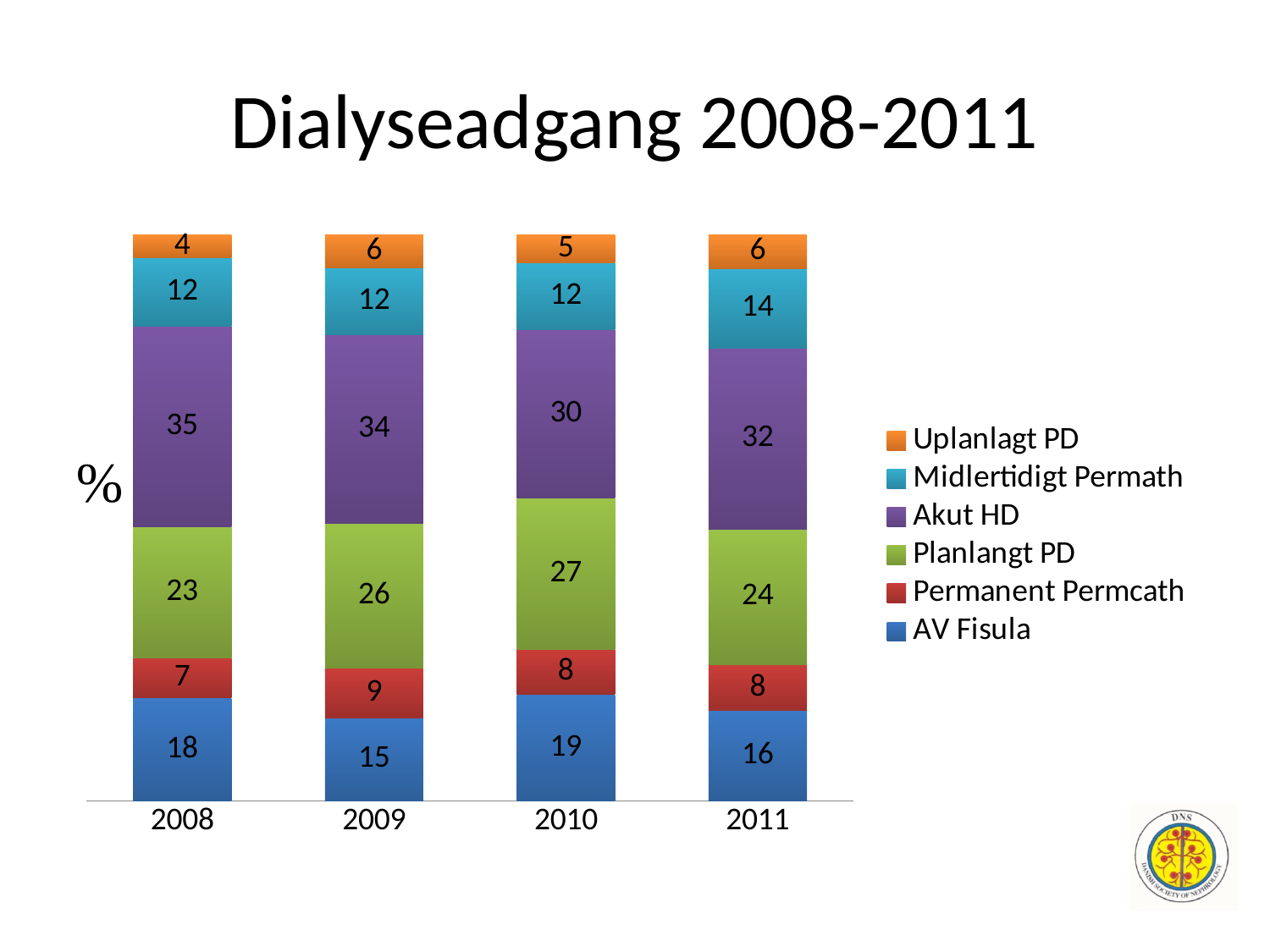
How many series does the legend list? 6 What is the value for Akut HD in 2008? 35 How many years are shown on the x axis? 4 In which year is the AV Fisula value lowest? 2009 What type of chart is shown on the slide? Stacked bar chart What is the title of the chart? Dialyseadgang 2008-2011 In which year is the Planlangt PD value highest? 2010 Which is larger, the Permanent Permcath value in 2009 or in 2008? 2009 What is the total of the stacked bar for 2011? 100 What is the value for AV Fisula in 2010? 19 What is the difference between the Akut HD values in 2008 and 2010? 5 What is the value for Midlertidigt Permath in 2011? 14